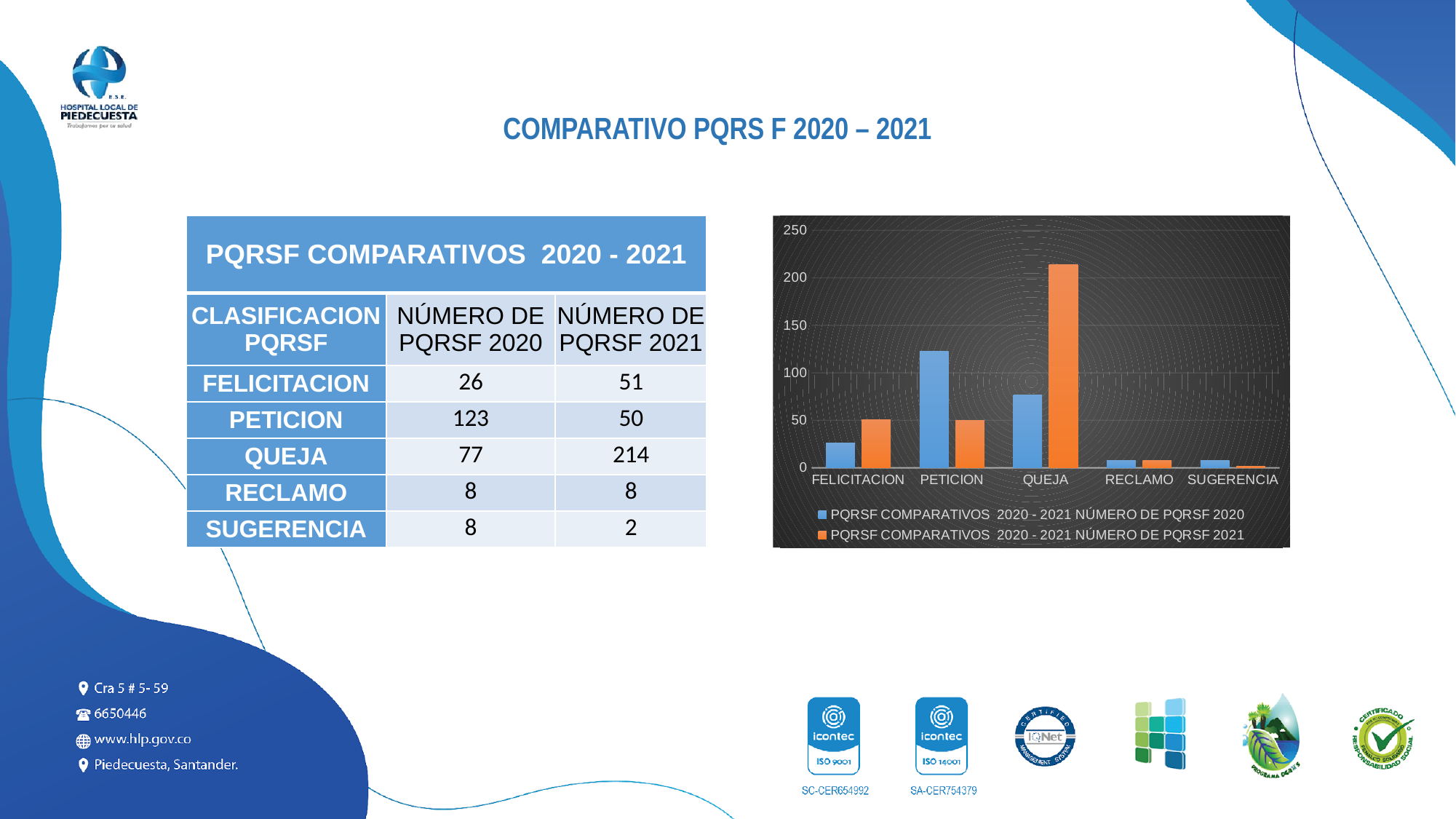
Is the value for FELICITACION in NÚMERO DE PQRSF 2020 greater or less than 50? less Is the value for PETICION in NÚMERO DE PQRSF 2020 greater or less than 100? greater What kind of chart is shown on the slide? bar chart What colour are the bars for NÚMERO DE PQRSF 2021 in the chart? orange How many categories are shown on the x axis of the chart? 5 Which category has the highest bar for NÚMERO DE PQRSF 2021? QUEJA Is the value for QUEJA in NÚMERO DE PQRSF 2021 greater or less than 200? greater How many series does the chart legend list? 2 What is the value for QUEJA in NÚMERO DE PQRSF 2021, as printed in the table on the slide? 214 Which category has the highest bar for NÚMERO DE PQRSF 2020? PETICION Which category has the lowest bar for NÚMERO DE PQRSF 2021? SUGERENCIA For PETICION, which series has the larger bar, NÚMERO DE PQRSF 2020 or NÚMERO DE PQRSF 2021? NÚMERO DE PQRSF 2020